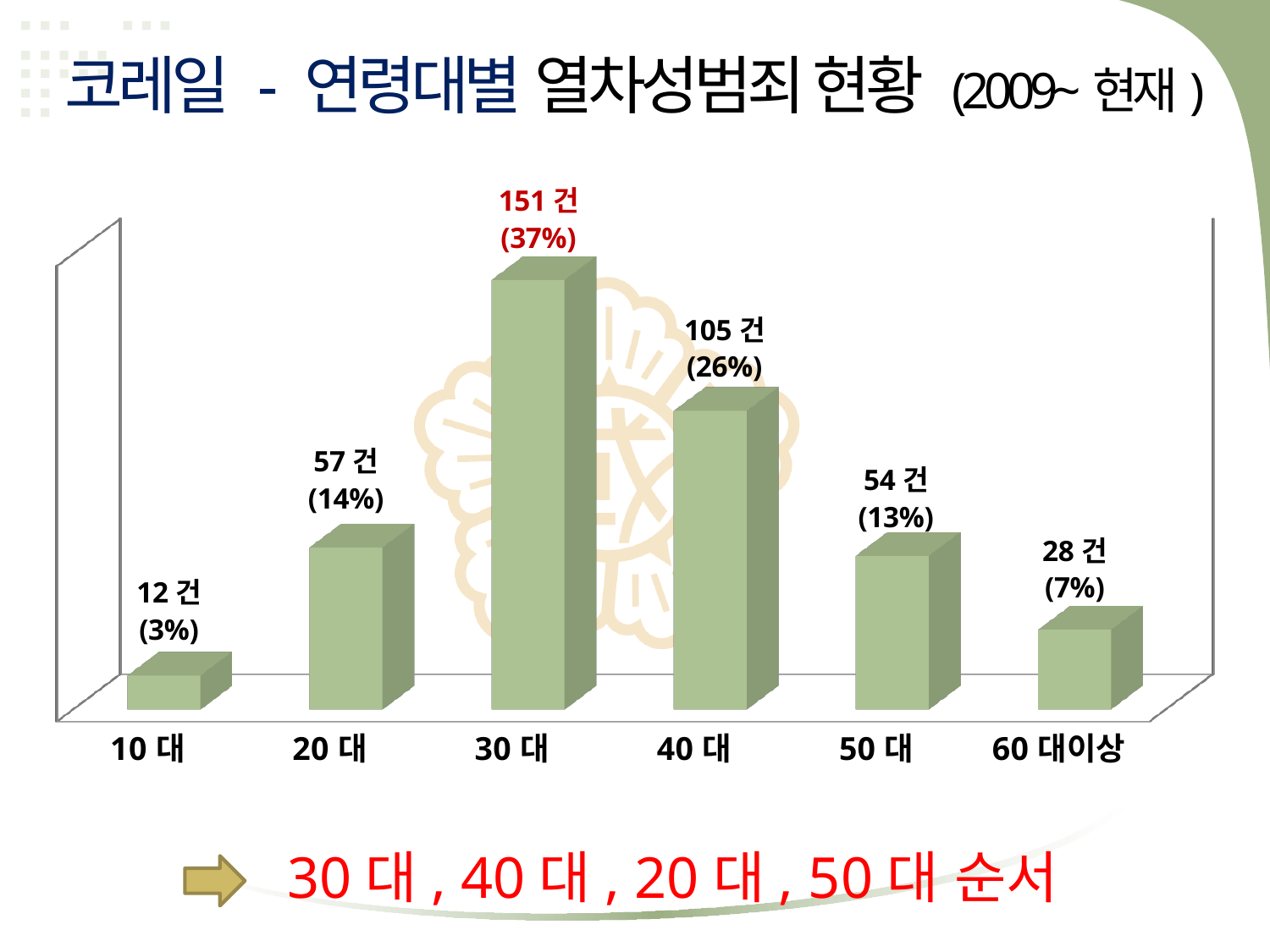
How many cases are shown for the 30대 age group? 151 건 Which age group has the highest number of cases? 30 대 How many cases are shown for the 60대이상 age group? 28 건 What percentage is shown for the 40대 age group? 26% How many age groups are shown on the chart? 6 What is the total number of cases across all six age groups? 407 건 What is the difference in cases between the 20대 and 50대 age groups? 3 건 What kind of chart is shown on the slide? Bar chart What is the difference in cases between the 30대 and 40대 age groups? 46 건 Which age group has more cases, 20대 or 60대이상? 20 대 What percentage is shown for the 10대 age group? 3% Which age group has the lowest number of cases? 10 대